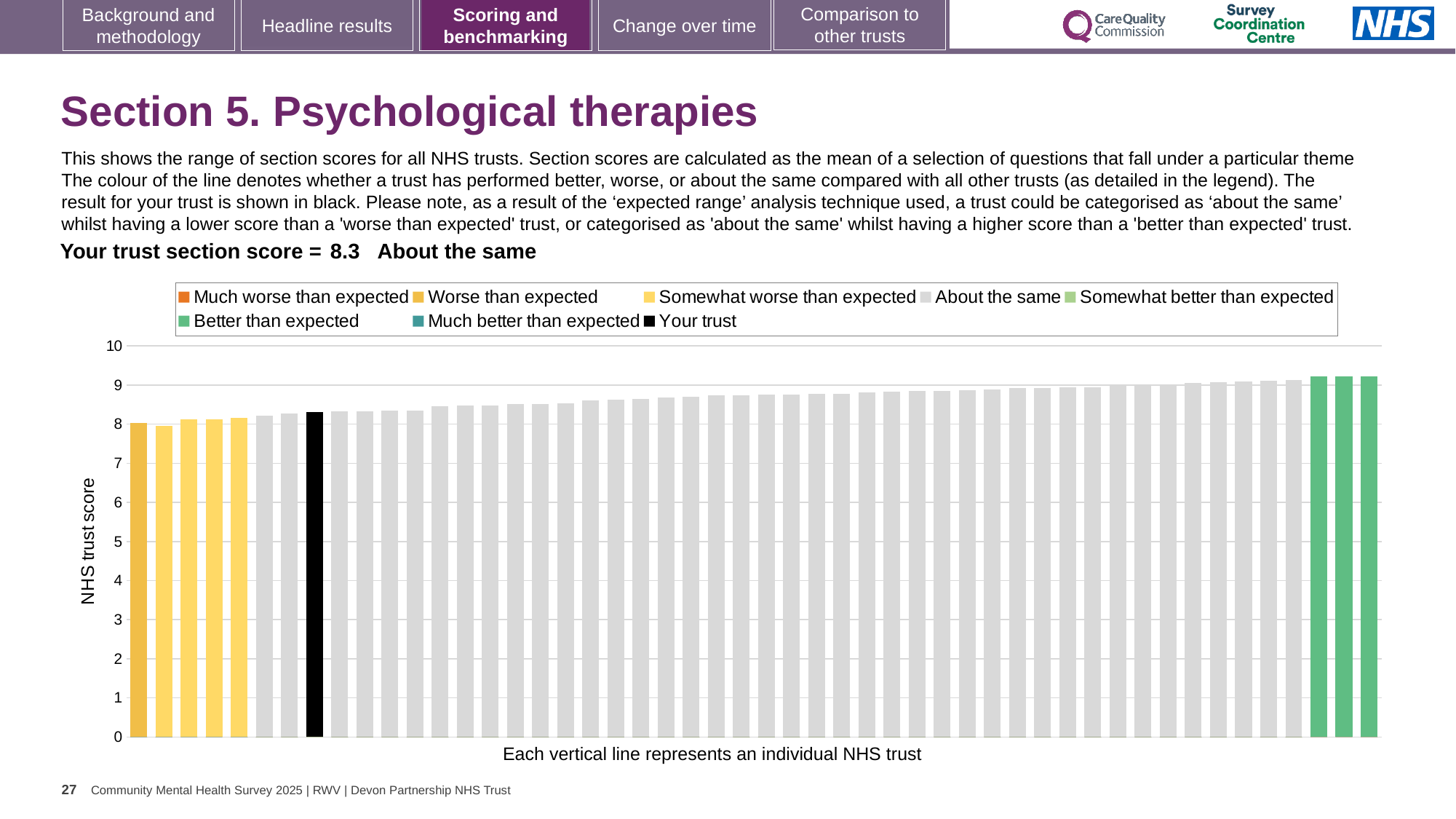
Is the value of the black bar (your trust) greater or less than 8? greater Are the tallest bars on the right of the chart greater or less than 9? greater Do the bar values rise or fall from left to right along the x axis? rise How many entries does the legend list? 8 Is the value of the leftmost bar greater or less than 7? greater What is your trust's section score for Psychological therapies? 8.3 What is the label on the vertical axis? NHS trust score How many bars are coloured green (Better than expected)? 3 What kind of chart is shown on the slide? bar chart Which category is your trust placed in for this section? About the same What colour is used for the 'Your trust' bar according to the legend? black